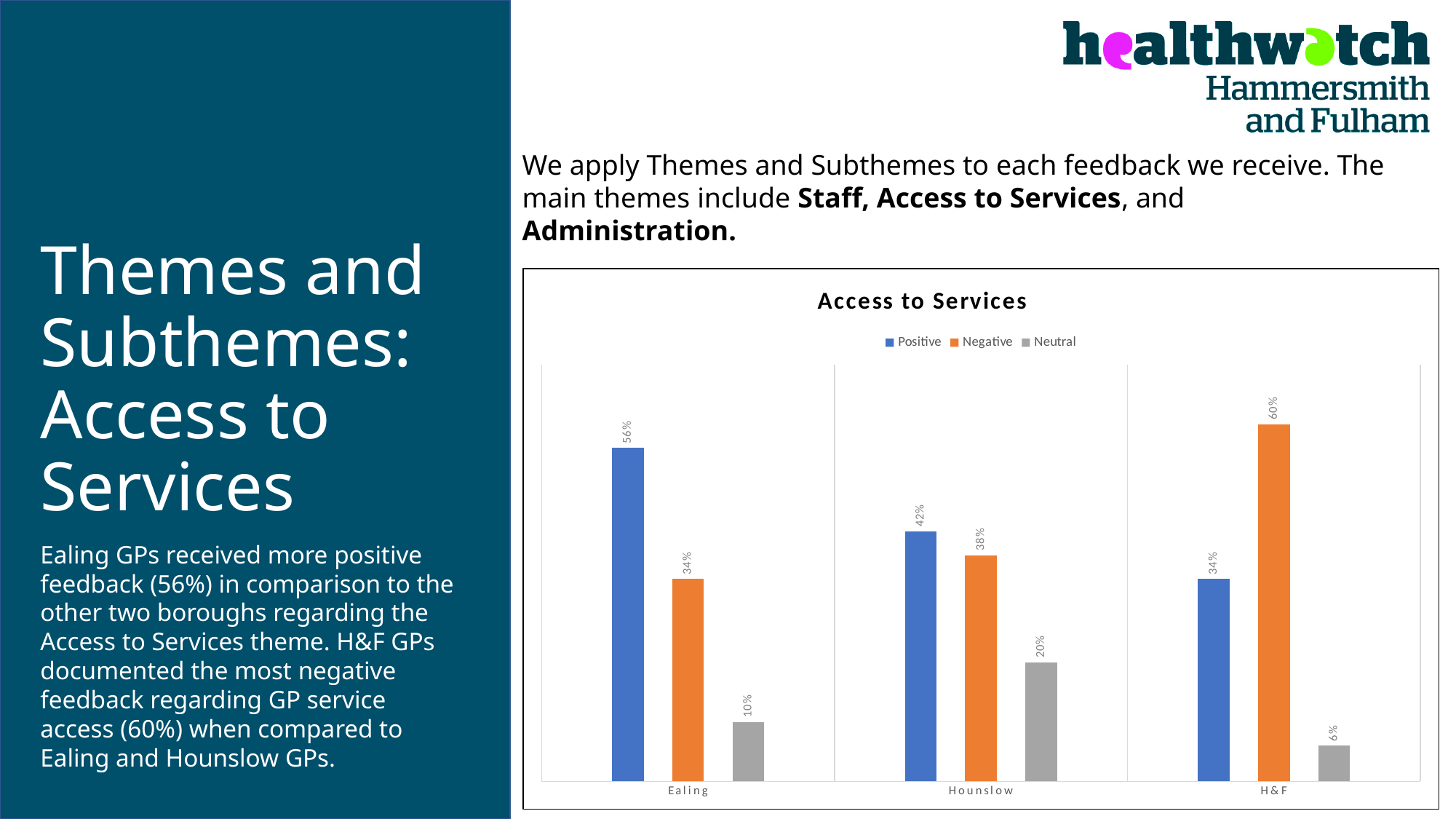
What kind of chart is shown? Bar chart Which borough has the lowest Neutral value? H&F How many boroughs are shown on the x axis? 3 What is the Positive value for Ealing? 56% What is the difference between the Positive values for Ealing and H&F? 22% Which is larger for Hounslow, the Positive value or the Negative value? Positive What is the Neutral value for Hounslow? 20% How many series does the legend list? 3 Do the Positive values rise or fall from Ealing to H&F? Fall What is the Negative value for H&F? 60% Which borough has the highest Negative value? H&F What is the title of the chart? Access to Services